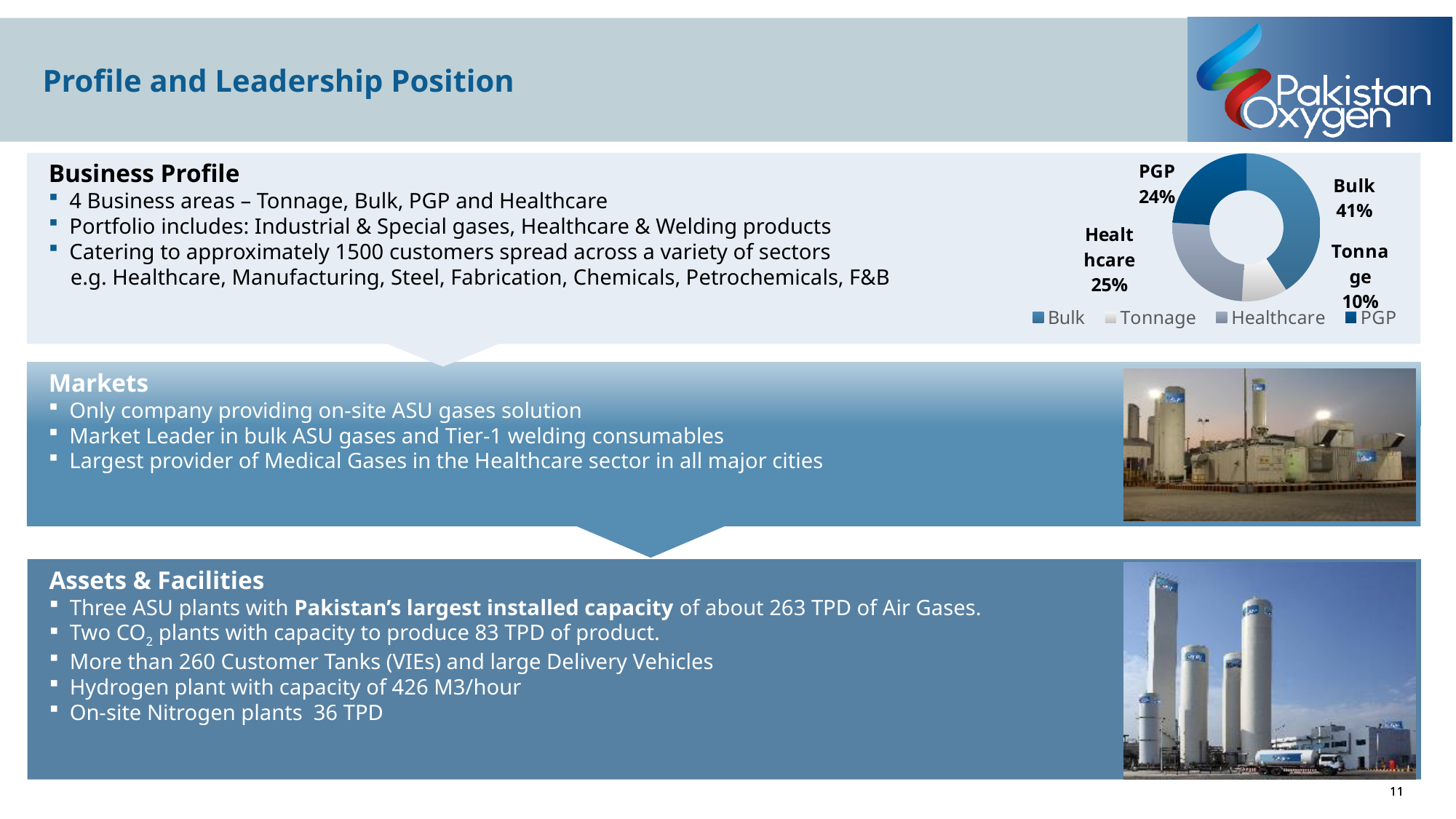
Which entries are listed in the chart legend? Bulk, Tonnage, Healthcare, PGP Which business area has the smallest share in the pie chart? Tonnage What is the difference in percentage points between the Bulk and Tonnage shares? 31 What share of the pie chart does Tonnage account for? 10% What share of the pie chart does Healthcare account for? 25% What kind of chart is shown on the slide? Pie chart (doughnut) How many business areas are shown in the pie chart? 4 Which business area has the largest share in the pie chart? Bulk What is the combined share of Healthcare and PGP in the pie chart? 49% What share of the pie chart does Bulk account for? 41% What share of the pie chart does PGP account for? 24% Which has a larger share, Healthcare or Tonnage? Healthcare